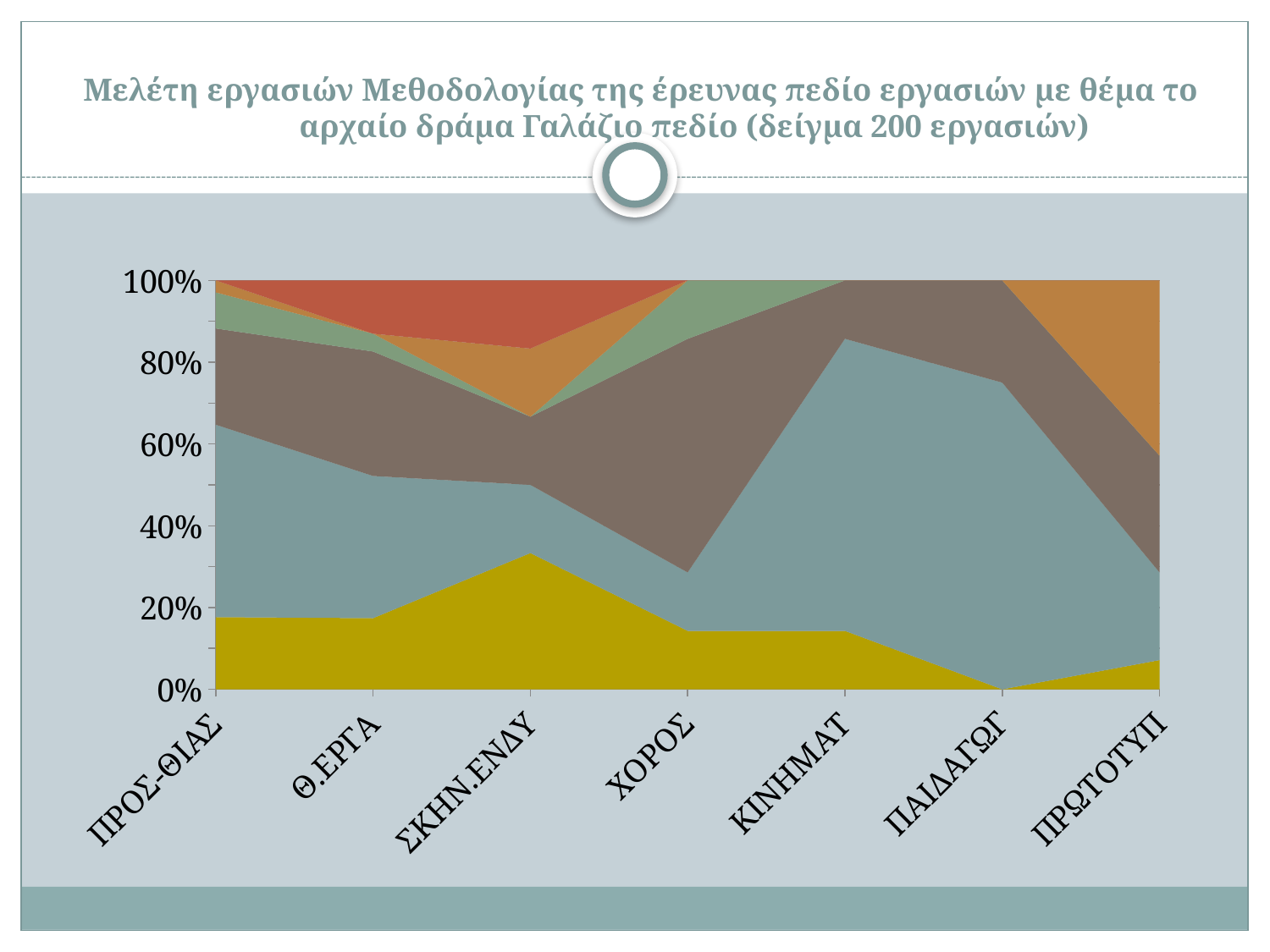
What kind of chart is shown on the slide? Stacked area chart Is the top of the teal (second from bottom) band at ΧΟΡΟΣ greater or less than 40%? less What is the maximum value shown on the y axis of the chart? 100% What is the last category on the x axis of the chart? ΠΡΩΤΟΤΥΠ Is the bottom (yellow) band at ΣΚΗΝ.ΕΝΔΥ greater or less than 20%? greater Is the top of the teal (second from bottom) band at ΚΙΝΗΜΑΤ greater or less than 80%? greater What is the first category on the x axis of the chart? ΠΡΟΣ-ΘΙΑΣ How many categories are shown along the x axis of the chart? 7